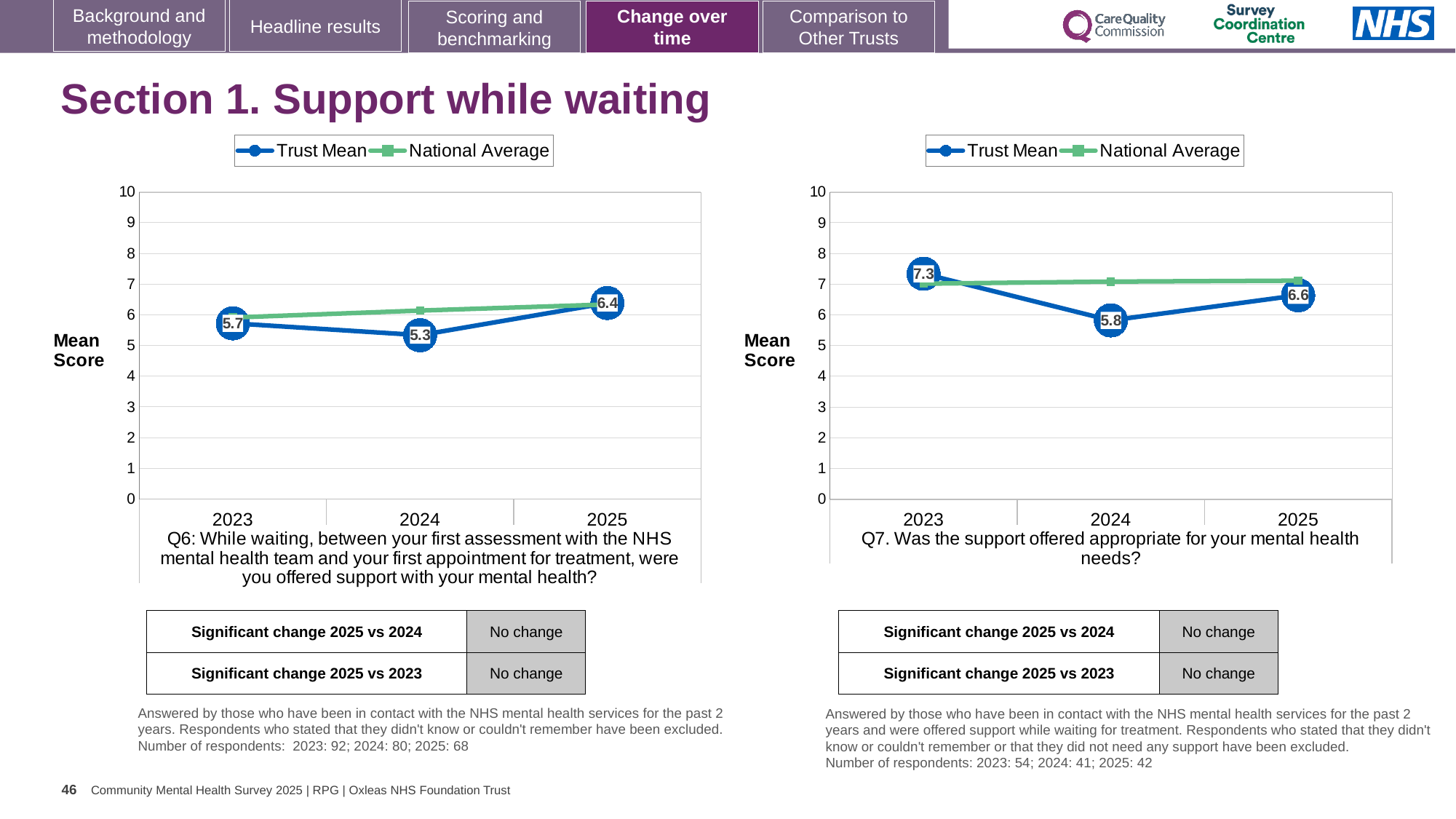
In the left chart (Q6), is the National Average for 2024 greater or less than 5? greater In the right chart (Q7), which year has the lowest Trust Mean score? 2024 In the left chart (Q6), what is the Trust Mean score for 2025? 6.4 In the left chart (Q6), what is the Trust Mean score for 2024? 5.3 In the left chart (Q6), what is the difference between the Trust Mean scores for 2025 and 2024? 1.1 In the right chart (Q7), what is the difference between the Trust Mean scores for 2023 and 2025? 0.7 How many series does the legend of the right chart (Q7) list? 2 What kind of chart is the left chart (Q6)? Line chart In the right chart (Q7), what is the Trust Mean score for 2023? 7.3 In the right chart (Q7), is the Trust Mean score for 2023 larger or smaller than the Trust Mean score for 2025? larger In the right chart (Q7), what is the Trust Mean score for 2024? 5.8 In the left chart (Q6), which year has the highest Trust Mean score? 2025